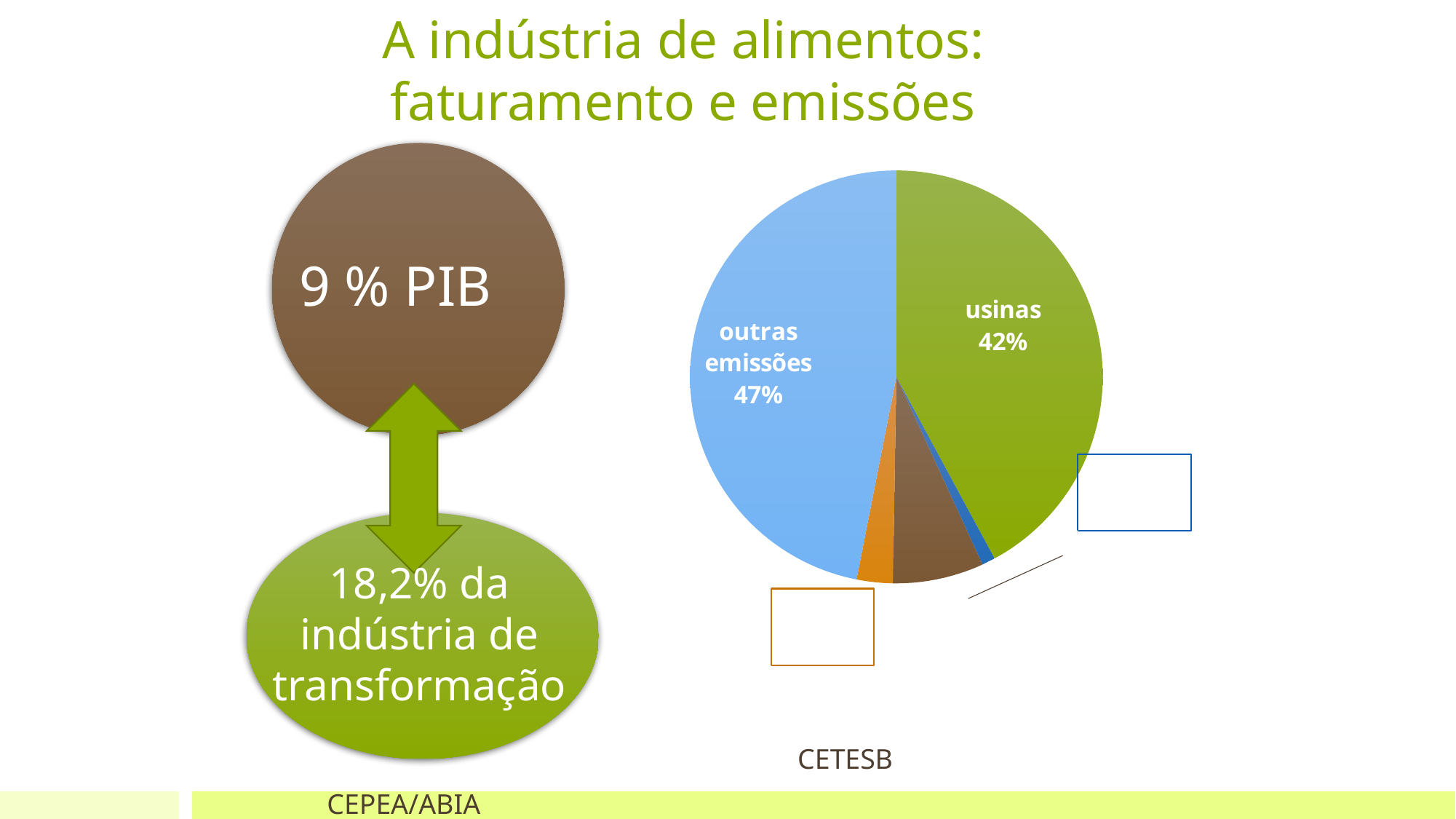
How many slices does the pie chart have? 5 What source is written below the pie chart? CETESB What kind of chart is shown on the right of the slide? Pie chart Which labelled slice of the pie chart is the largest? outras emissões What share of the pie chart is labelled "outras emissões"? 47% Which is larger in the pie chart, "outras emissões" or "usinas"? outras emissões What share of the pie chart is labelled "usinas"? 42% By how many percentage points does "outras emissões" exceed "usinas" in the pie chart? 5 percentage points What colour is the "usinas" slice in the pie chart? Green